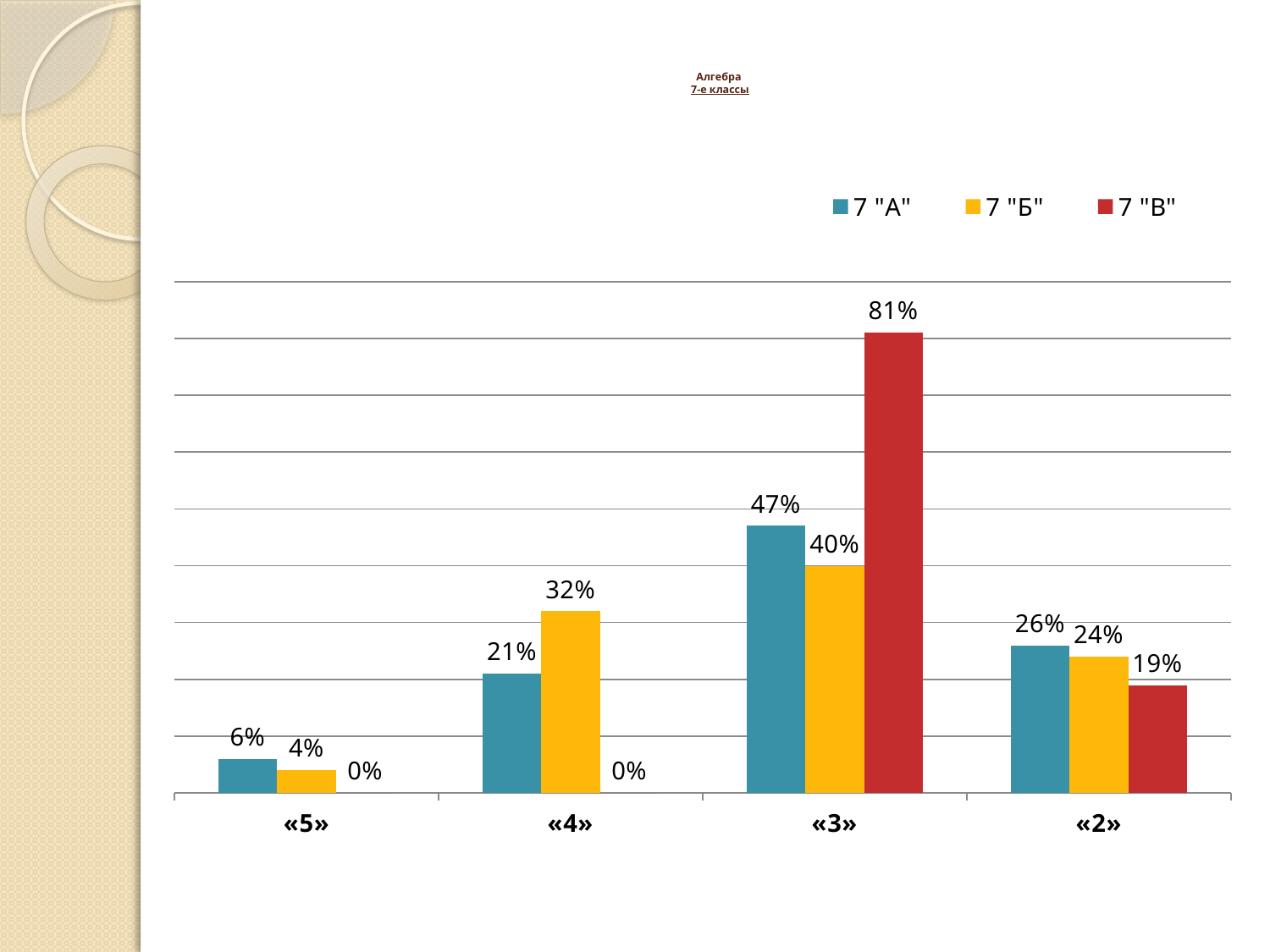
What is the difference between the 7 "В" and 7 "А" values in the «3» category? 34% Which category has the highest value for 7 "А"? «3» What is the value for 7 "В" in the «3» category? 81% What kind of chart is shown on the slide? Bar chart Which is larger in the «2» category: 7 "Б" or 7 "В"? 7 "Б" What is the value for 7 "А" in the «2» category? 26% What is the value for 7 "Б" in the «4» category? 32% How many categories are shown on the x axis? 4 What is the value for 7 "В" in the «5» category? 0% Which category has the lowest value for 7 "Б"? «5» What is the title of the chart? Алгебра 7-е классы How many series does the legend list? 3